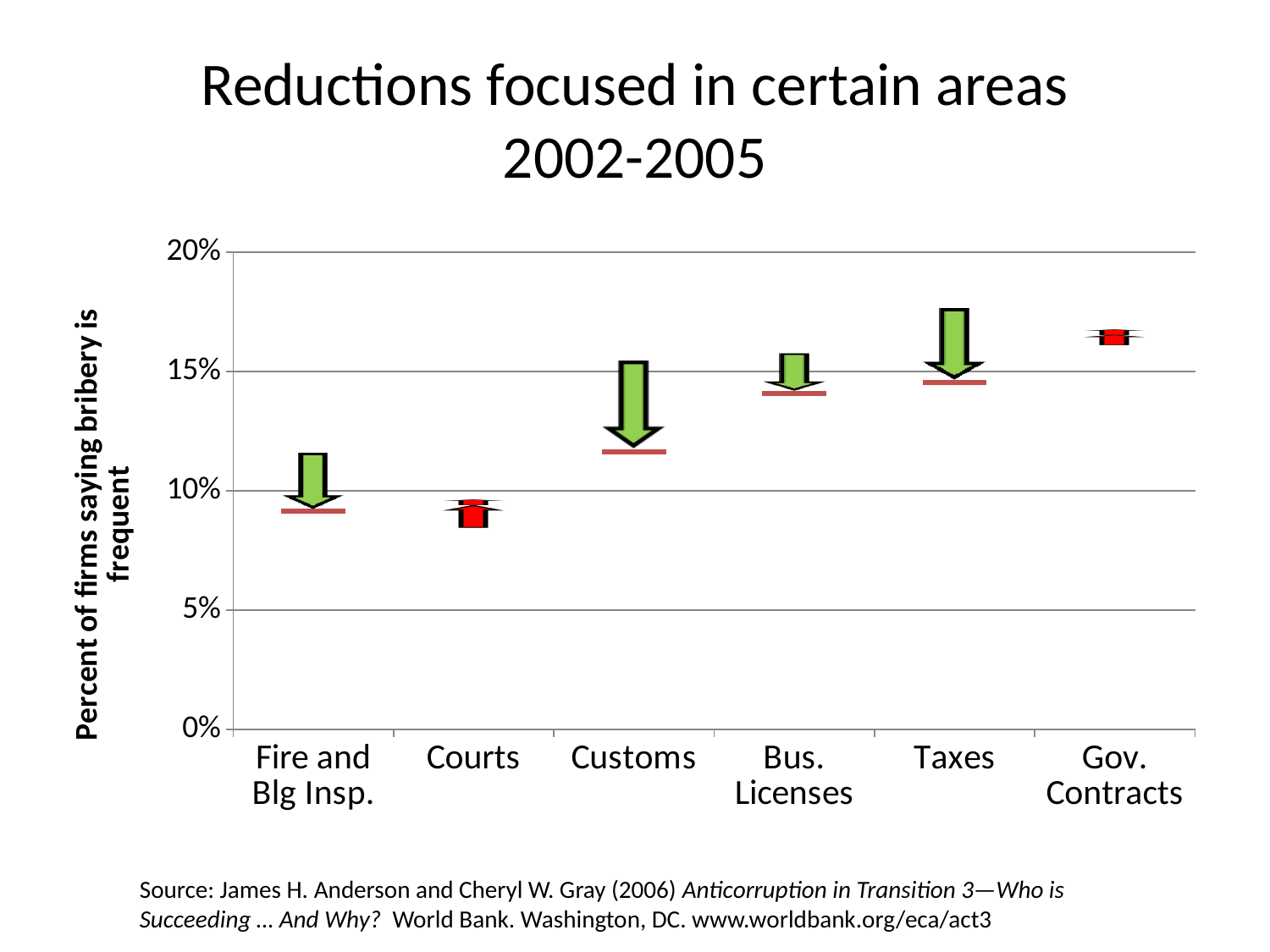
Which is larger, the value for Customs or the value for Fire and Blg Insp.? Customs What is the label of the y axis? Percent of firms saying bribery is frequent Which two categories are marked with red arrows instead of green arrows? Courts and Gov. Contracts Do the values generally rise or fall moving from left to right along the x axis? rise Is the value for Courts greater or less than 10%? less Which is larger, the value for Taxes or the value for Courts? Taxes Is the value for Customs greater or less than 10%? greater How many categories are shown on the x axis of the chart? 6 Is the value for Gov. Contracts greater or less than 15%? greater